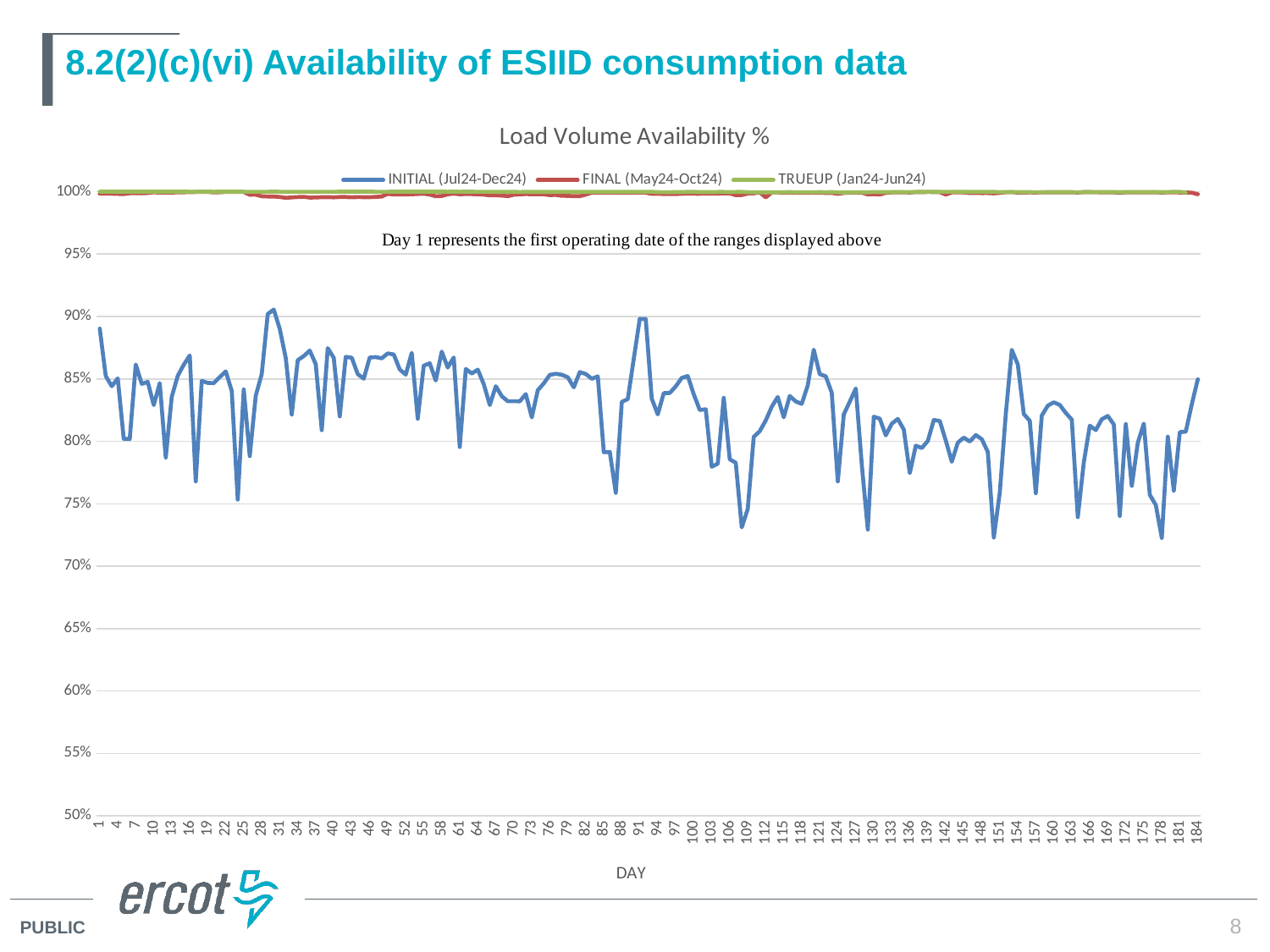
Which series is shown in blue in the legend? INITIAL (Jul24-Dec24) Is the value of the INITIAL (Jul24-Dec24) series at day 1 greater or less than 85%? greater What is the title of the chart? Load Volume Availability % What is the last day label shown on the x axis? 184 At day 91, which series has the larger value: INITIAL (Jul24-Dec24) or FINAL (May24-Oct24)? FINAL (May24-Oct24) What is the x-axis title of the chart? DAY Which series has the lowest values across the chart? INITIAL (Jul24-Dec24) What kind of chart is shown on the slide? Line chart Does the TRUEUP (Jan24-Jun24) series rise, fall, or stay roughly flat across the days? Stays roughly flat Is the value of the TRUEUP (Jan24-Jun24) series at day 100 greater or less than 95%? greater How many series does the legend list? 3